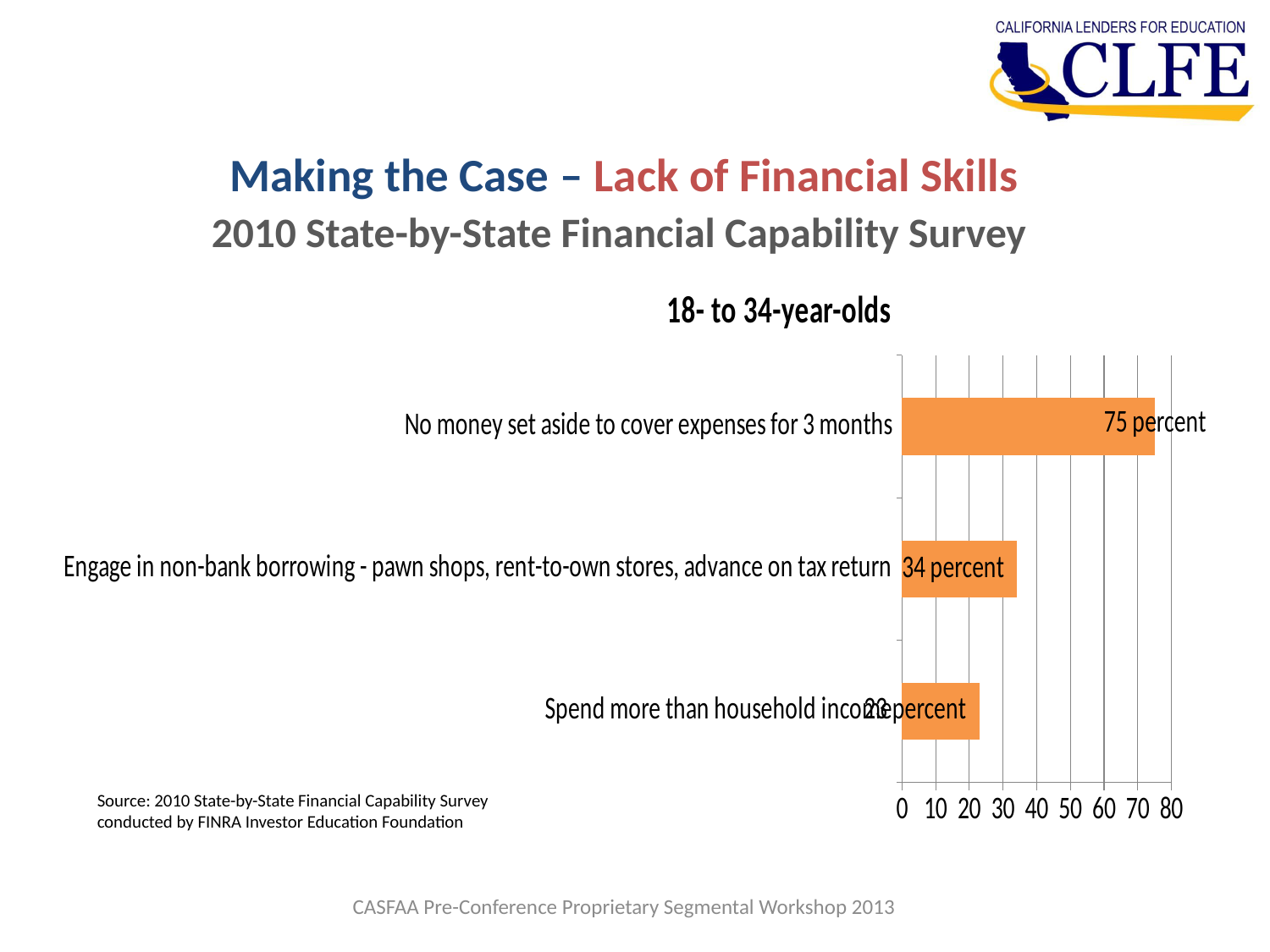
Is the value for "Spend more than household income" greater or less than 30? less What is the maximum value shown on the chart's horizontal axis? 80 What is the value for "Engage in non-bank borrowing - pawn shops, rent-to-own stores, advance on tax return"? 34 percent Which category has the lowest value? Spend more than household income Which is larger: the value for "Engage in non-bank borrowing" or the value for "Spend more than household income"? Engage in non-bank borrowing What is the difference between the values for "No money set aside to cover expenses for 3 months" and "Engage in non-bank borrowing - pawn shops, rent-to-own stores, advance on tax return"? 41 percent Which category has the highest value? No money set aside to cover expenses for 3 months How many categories are shown in the chart? 3 What kind of chart is shown on the slide? Bar chart What is the value for "No money set aside to cover expenses for 3 months"? 75 percent What is the title of the chart? 18- to 34-year-olds Is the value for "No money set aside to cover expenses for 3 months" greater or less than 70? greater